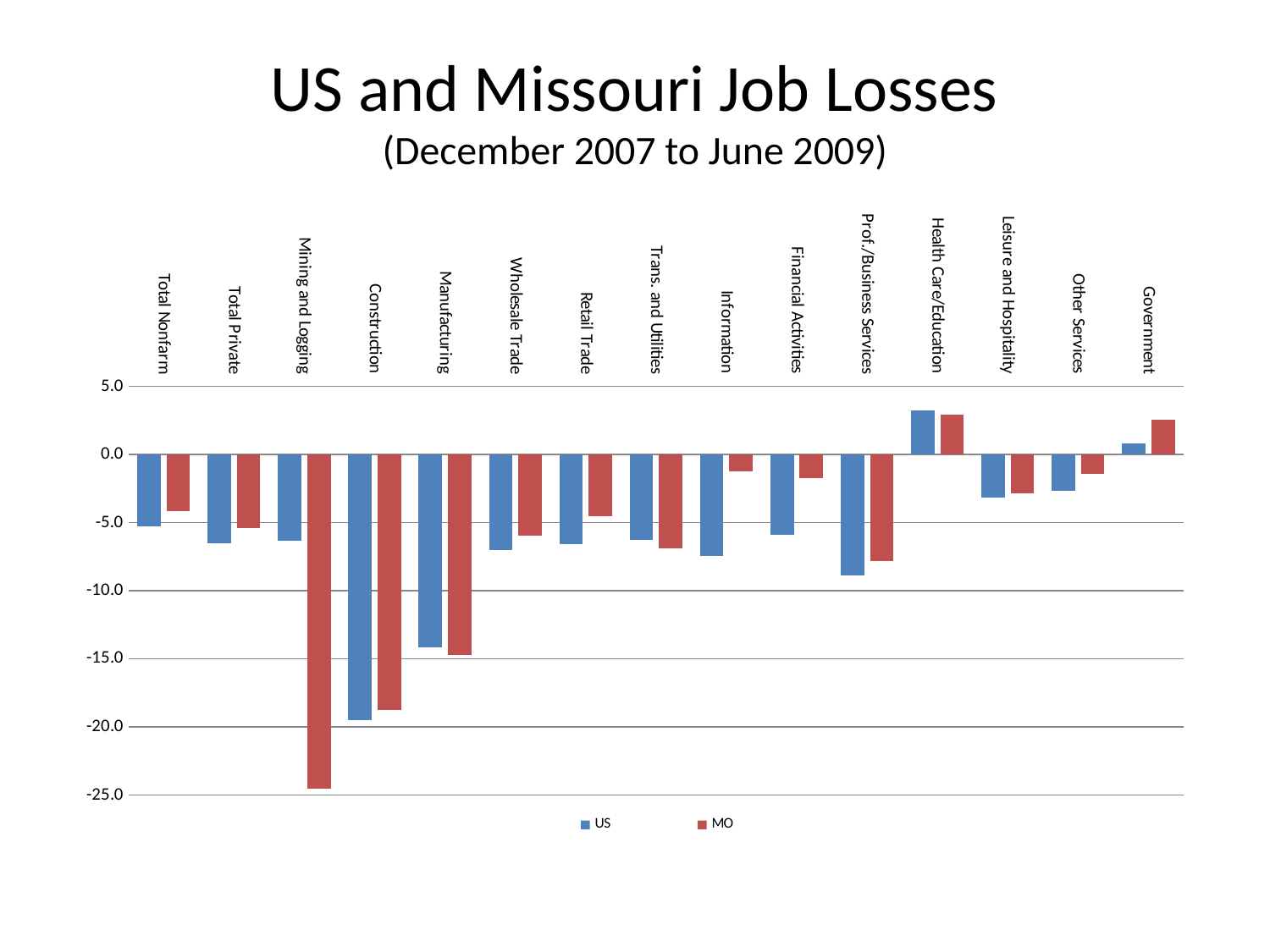
For Mining and Logging, which series has the larger value, US or MO? US Which category has the highest US value? Health Care/Education Is the US value for Manufacturing greater or less than -10.0? less Which category has the lowest US value? Construction How many categories are plotted along the x axis? 15 Is the US value for Construction greater or less than -15.0? less Is the MO value for Information greater or less than -5.0? greater For Financial Activities, which series has the larger value, US or MO? MO How many series does the legend list? 2 What kind of chart is shown on the slide? bar chart Which category has the lowest MO value? Mining and Logging